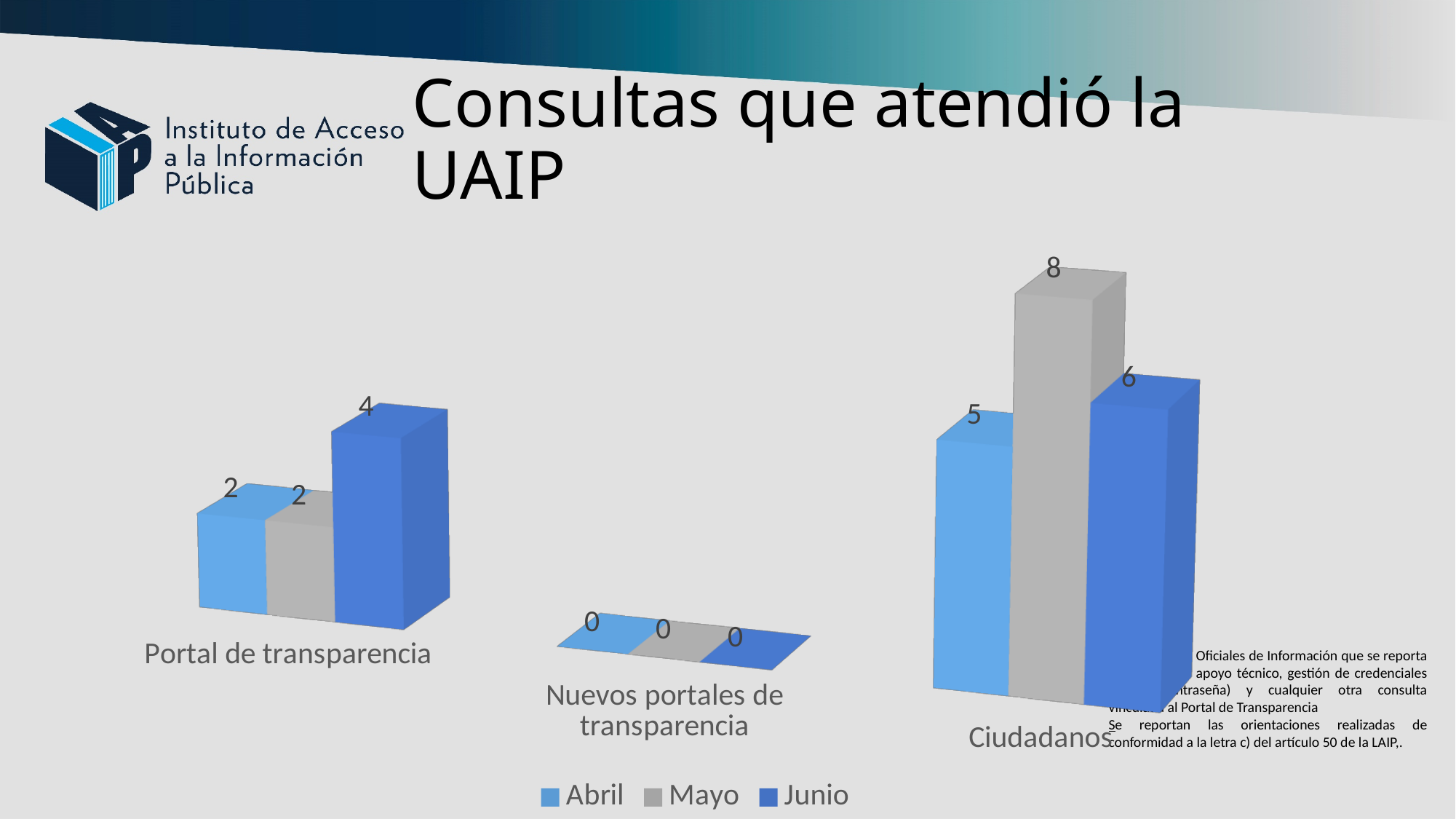
How many categories are shown on the x axis? 3 Which category has the lowest value for Junio? Nuevos portales de transparencia What is the value for Abril in the Nuevos portales de transparencia category? 0 What is the title of the slide containing the chart? Consultas que atendió la UAIP What is the difference between the Mayo and Junio values in the Ciudadanos category? 2 What is the value for Abril in the Ciudadanos category? 5 In the Portal de transparencia category, which is larger, the Abril value or the Junio value? Junio What is the value for Junio in the Portal de transparencia category? 4 Which category has the highest value for Mayo? Ciudadanos What kind of chart is shown on the slide? Bar chart How many series does the legend list? 3 What is the value for Mayo in the Ciudadanos category? 8